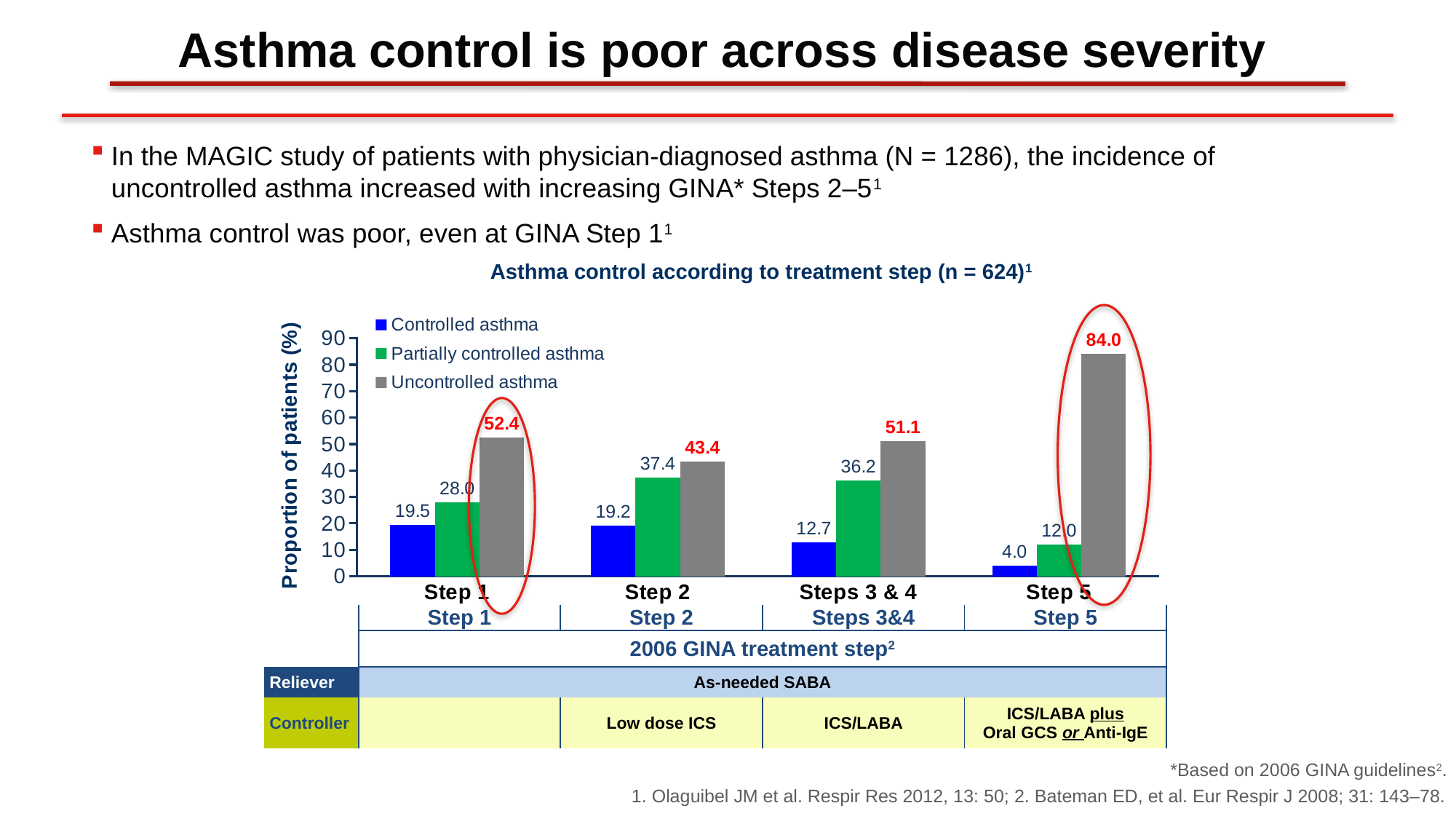
Which is larger: Partially controlled asthma at Step 2 or Partially controlled asthma at Steps 3 & 4? Partially controlled asthma at Step 2 What is the difference between the Uncontrolled asthma values at Step 5 and Step 1? 31.6 How many treatment step categories are shown on the x axis? 4 What kind of chart is shown on the slide? Bar chart Which treatment step has the lowest value for Controlled asthma? Step 5 What is the value for Partially controlled asthma at Step 2? 37.4 How many series does the legend list? 3 What is the value for Uncontrolled asthma at Step 5? 84.0 What is the value for Controlled asthma at Step 1? 19.5 What is the value for Uncontrolled asthma at Steps 3 & 4? 51.1 Does the Controlled asthma value rise or fall from Step 1 to Step 5? Fall Which treatment step has the highest value for Uncontrolled asthma? Step 5